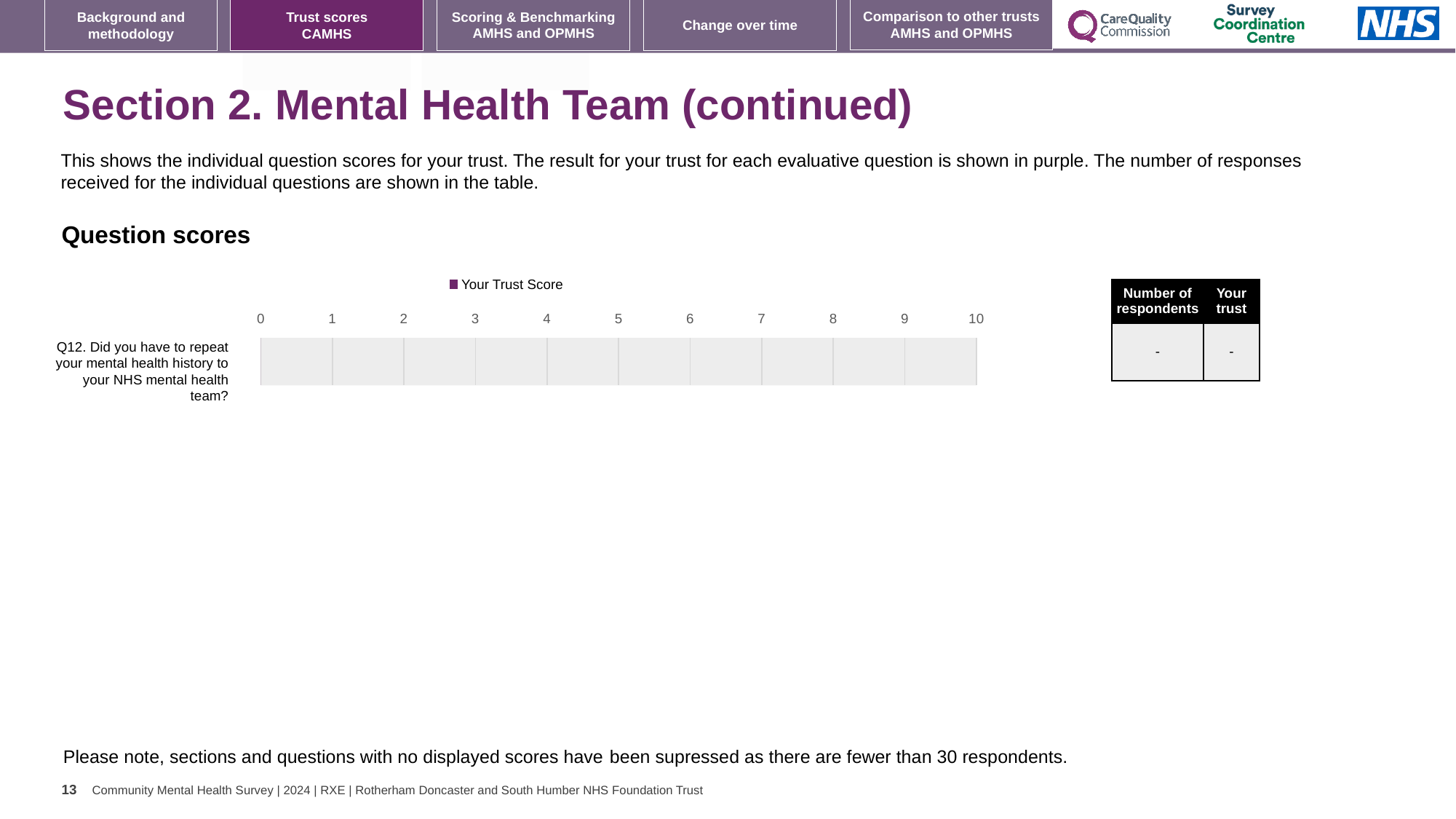
What is the name of the series shown in the chart legend? Your Trust Score How many series does the chart legend list? 1 How many questions (categories) are listed on the chart? 1 What kind of chart is shown under 'Question scores'? bar chart What is the highest value shown on the chart's horizontal axis? 10 What value does the table show for 'Your trust' for Q12? - What value does the table show for 'Number of respondents' for Q12? -